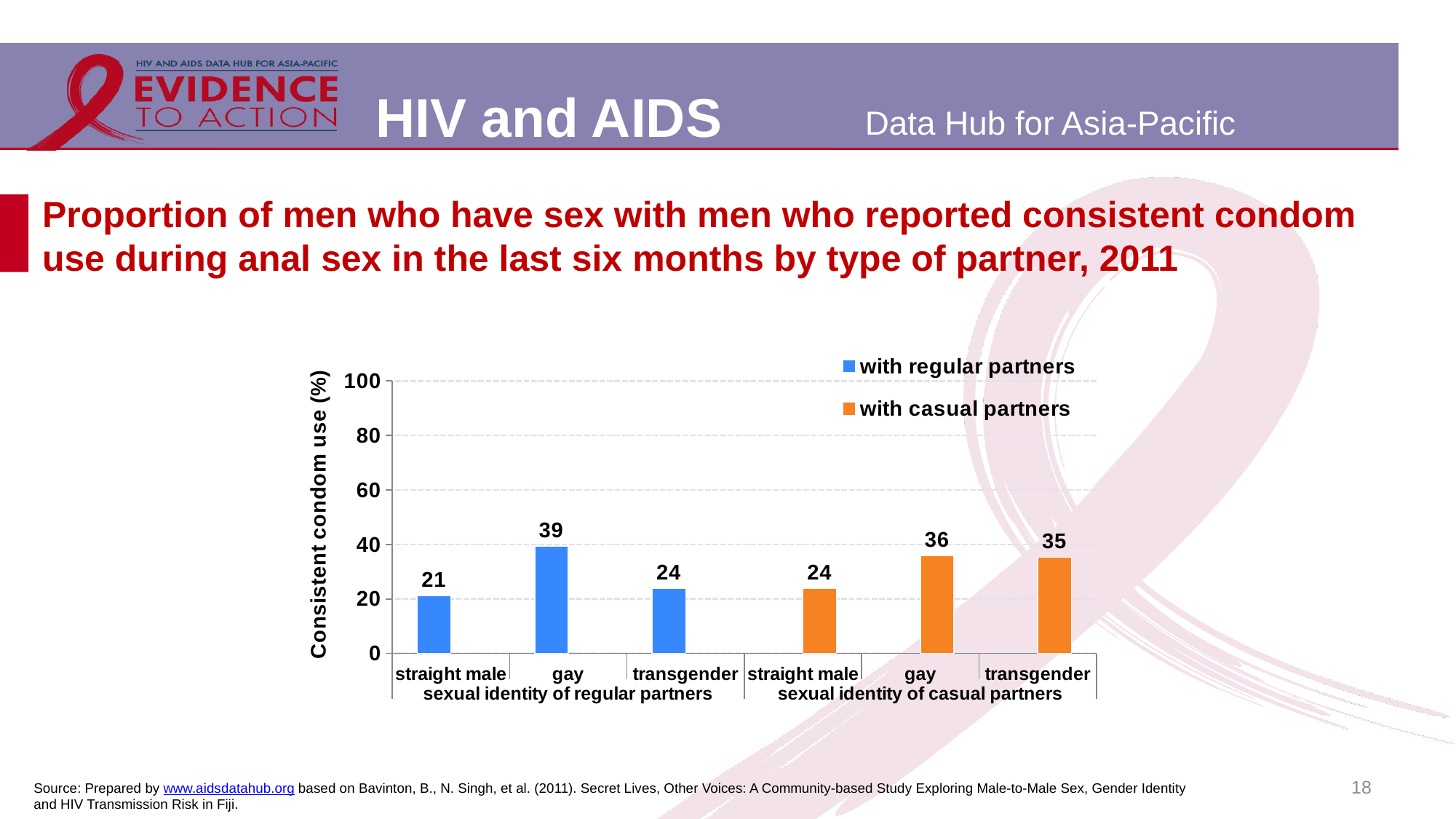
How many series does the legend list? 2 What kind of chart is shown on the slide? bar chart What is the consistent condom use value for straight male casual partners? 24 What is the difference between the value for gay regular partners and gay casual partners? 3 How many bars are plotted in the chart? 6 What is the value for transgender casual partners? 35 Which category has the lowest consistent condom use value? straight male (regular partners) Which is larger: the value for gay regular partners or transgender casual partners? gay regular partners Is the value for gay casual partners greater or less than 40? less What is the consistent condom use value for gay regular partners? 39 Which category has the highest consistent condom use value? gay (regular partners) What is the difference between the value for straight male regular partners and transgender regular partners? 3